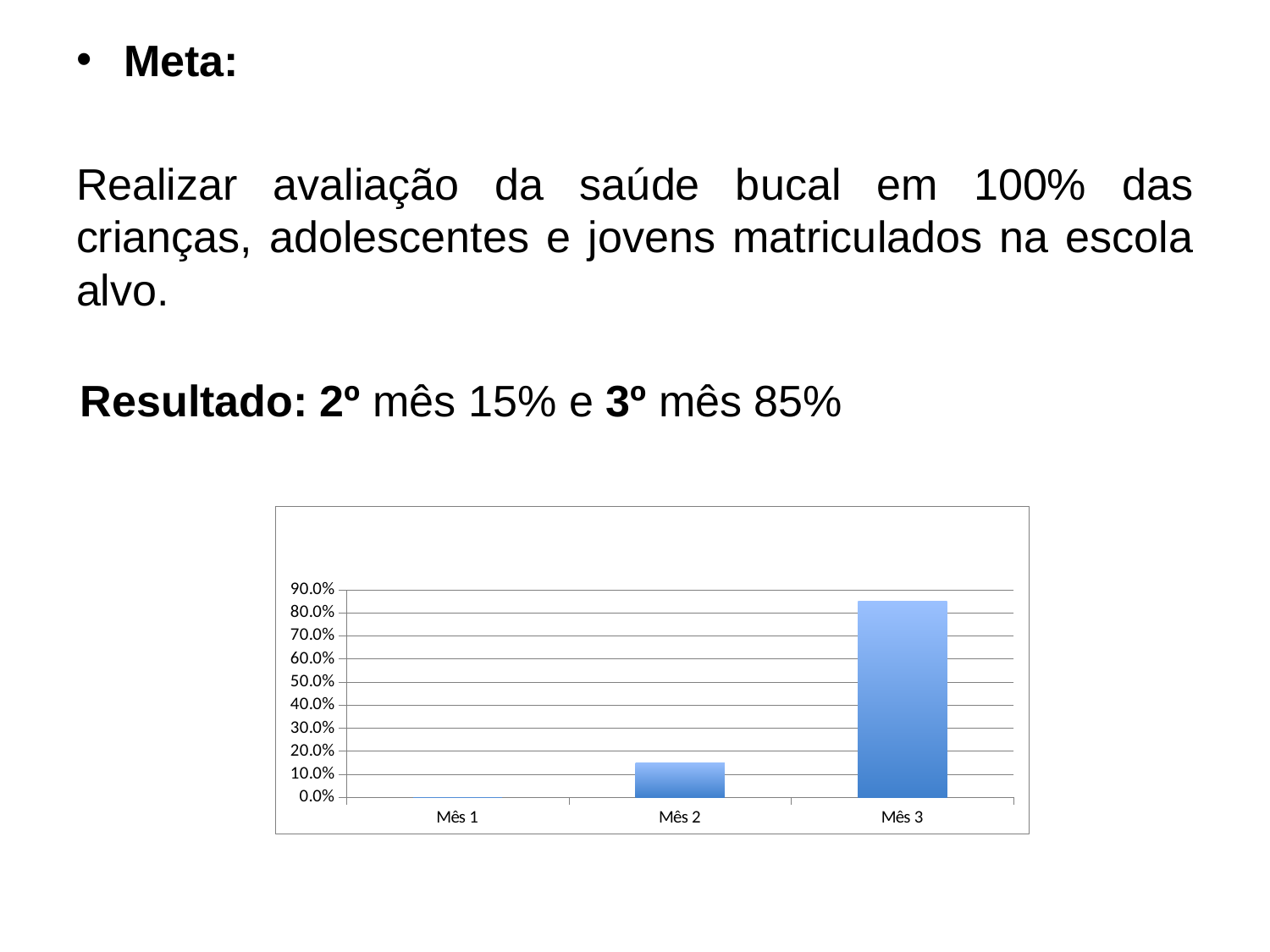
Which category has the highest bar in the chart? Mês 3 Is the value for Mês 2 greater or less than 20.0%? less Is the value for Mês 3 greater or less than 90.0%? less Is the value for Mês 3 greater or less than 80.0%? greater What is the highest tick label on the vertical axis of the chart? 90.0% Which category has the lowest bar in the chart? Mês 1 How many categories are shown on the x axis of the chart? 3 Do the values rise or fall from Mês 1 to Mês 3 in the chart? rise What kind of chart is shown on the slide? bar chart What is the value shown for Mês 1 in the chart? 0.0% Which is larger in the chart, the value for Mês 2 or the value for Mês 3? Mês 3